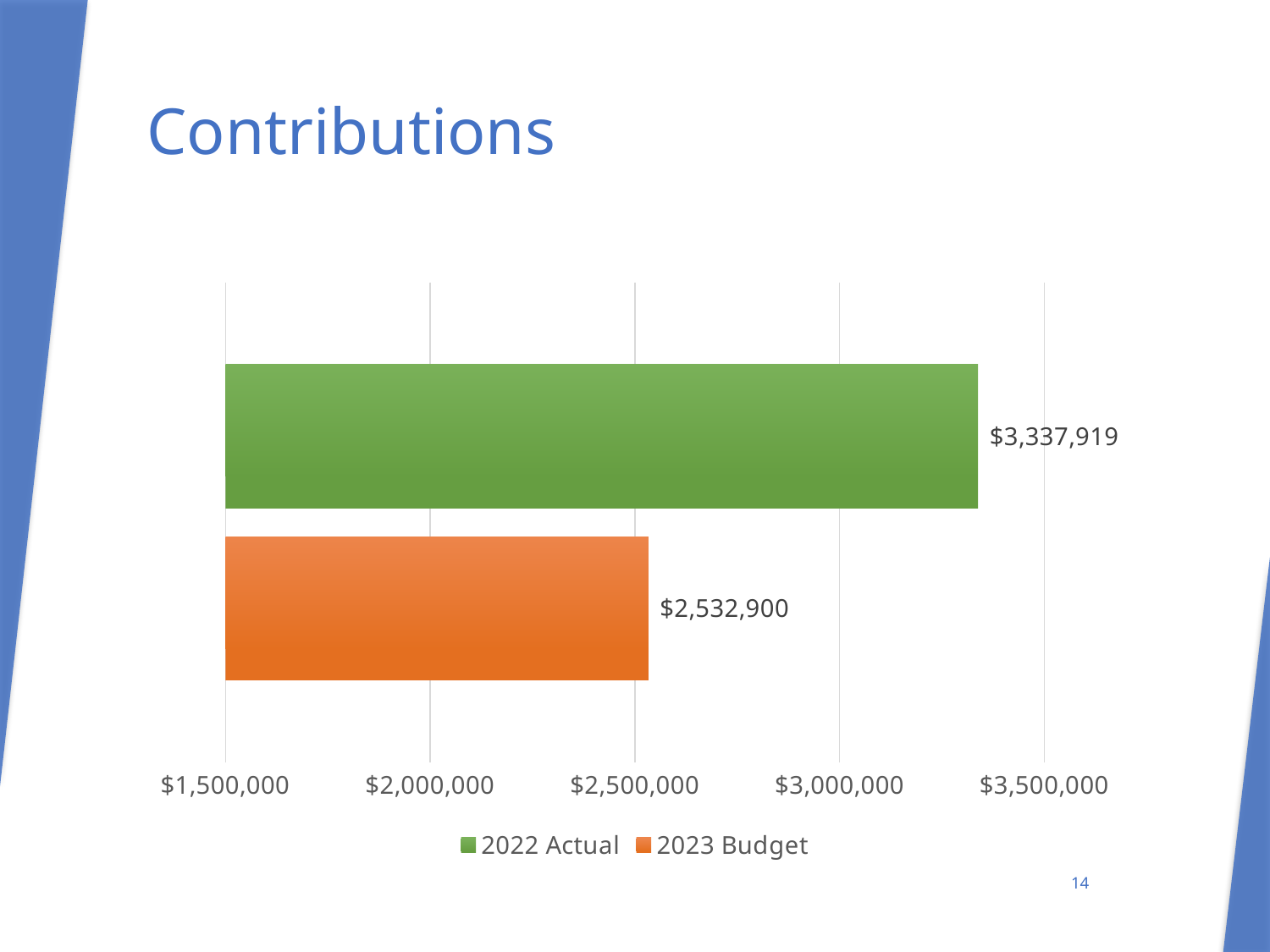
Which series has the higher value, 2022 Actual or 2023 Budget? 2022 Actual What is the title of the slide containing the chart? Contributions What is the value for 2022 Actual? $3,337,919 What is the value for 2023 Budget? $2,532,900 Which series has the lower value? 2023 Budget Is the value for 2023 Budget larger or smaller than the value for 2022 Actual? smaller How many series does the legend list? 2 What kind of chart is shown on the slide? bar chart What is the difference between the 2022 Actual and 2023 Budget values? $805,019 How many bars are plotted on the chart? 2 Is the value for 2023 Budget greater or less than $3,000,000? less Is the value for 2022 Actual greater or less than $3,000,000? greater